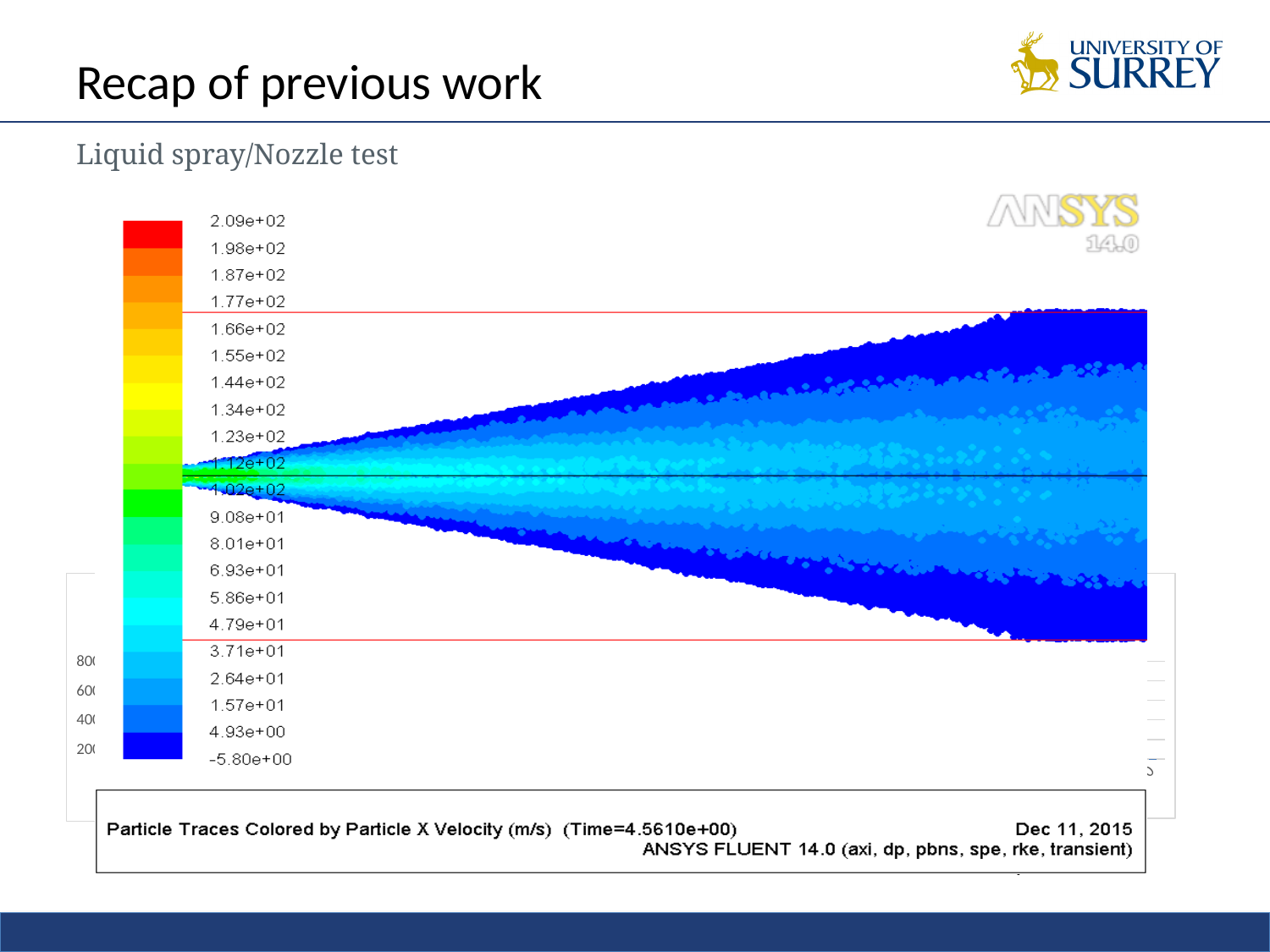
Which is larger on the colour scale, the value labelled 9.08e+01 or the value labelled 1.02e+02? 1.02e+02 What kind of plot is shown on the slide? Particle trace (contour) plot What quantity and unit are the particle traces coloured by? Particle X Velocity (m/s) What is the highest value shown on the colour scale of the particle trace plot? 2.09e+02 At what simulation time was the particle trace plot taken? 4.5610e+00 How many labelled levels does the colour scale of the particle trace plot have? 21 Is the top value of the colour scale greater or less than 200? greater What is the lowest value shown on the colour scale of the particle trace plot? -5.80e+00